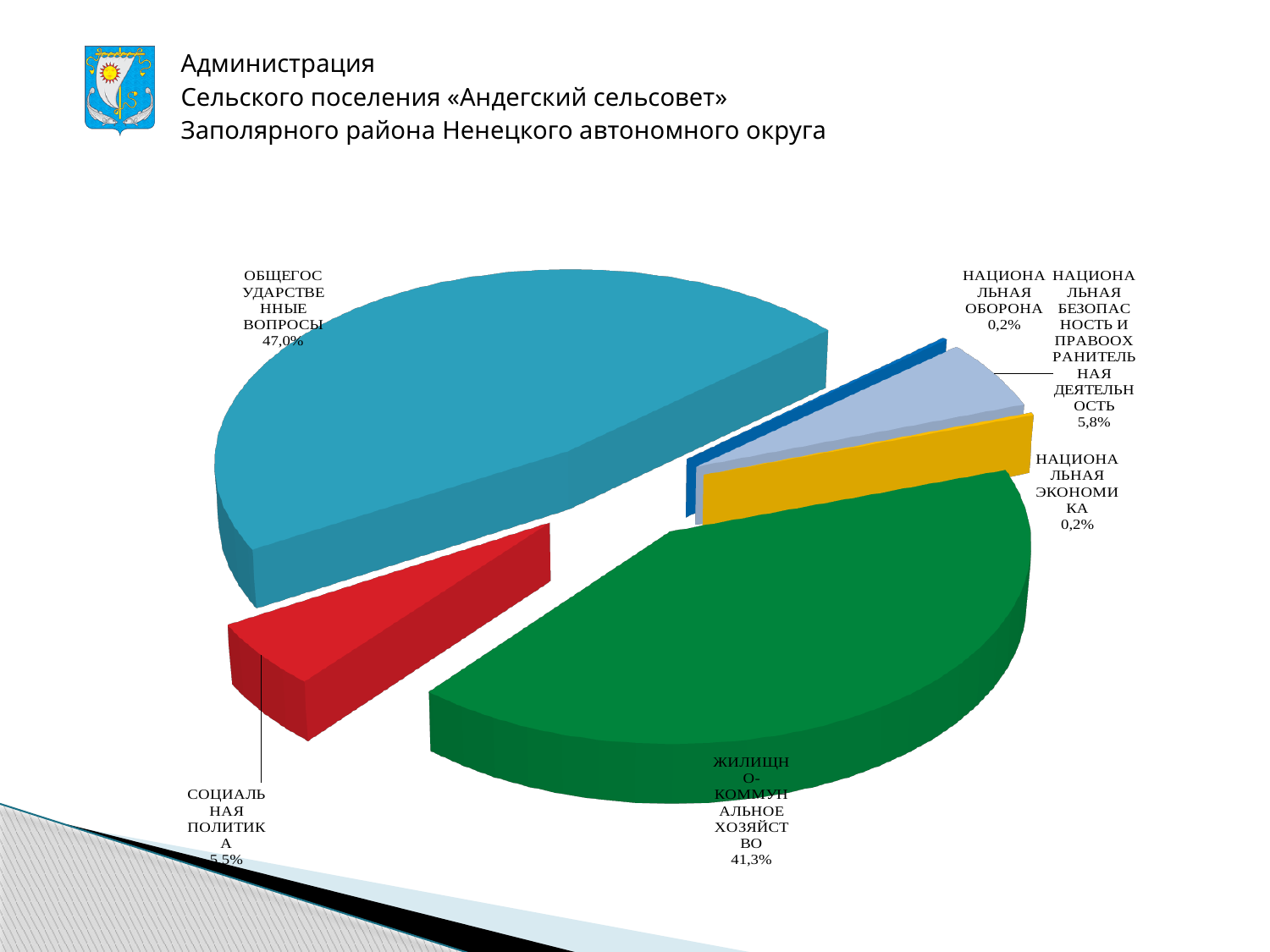
What share of the pie is ОБЩЕГОСУДАРСТВЕННЫЕ ВОПРОСЫ? 47,0% What share of the pie is СОЦИАЛЬНАЯ ПОЛИТИКА? 5,5% Which category has the largest slice of the pie? ОБЩЕГОСУДАРСТВЕННЫЕ ВОПРОСЫ What colour is the slice for ЖИЛИЩНО-КОММУНАЛЬНОЕ ХОЗЯЙСТВО? green What kind of chart is shown on the slide? pie chart What share of the pie is НАЦИОНАЛЬНАЯ ОБОРОНА? 0,2% How many slices does the pie chart have? 6 What is the difference in percentage points between ОБЩЕГОСУДАРСТВЕННЫЕ ВОПРОСЫ and ЖИЛИЩНО-КОММУНАЛЬНОЕ ХОЗЯЙСТВО? 5,7 Which is larger: the share for СОЦИАЛЬНАЯ ПОЛИТИКА or the share for НАЦИОНАЛЬНАЯ ОБОРОНА? СОЦИАЛЬНАЯ ПОЛИТИКА